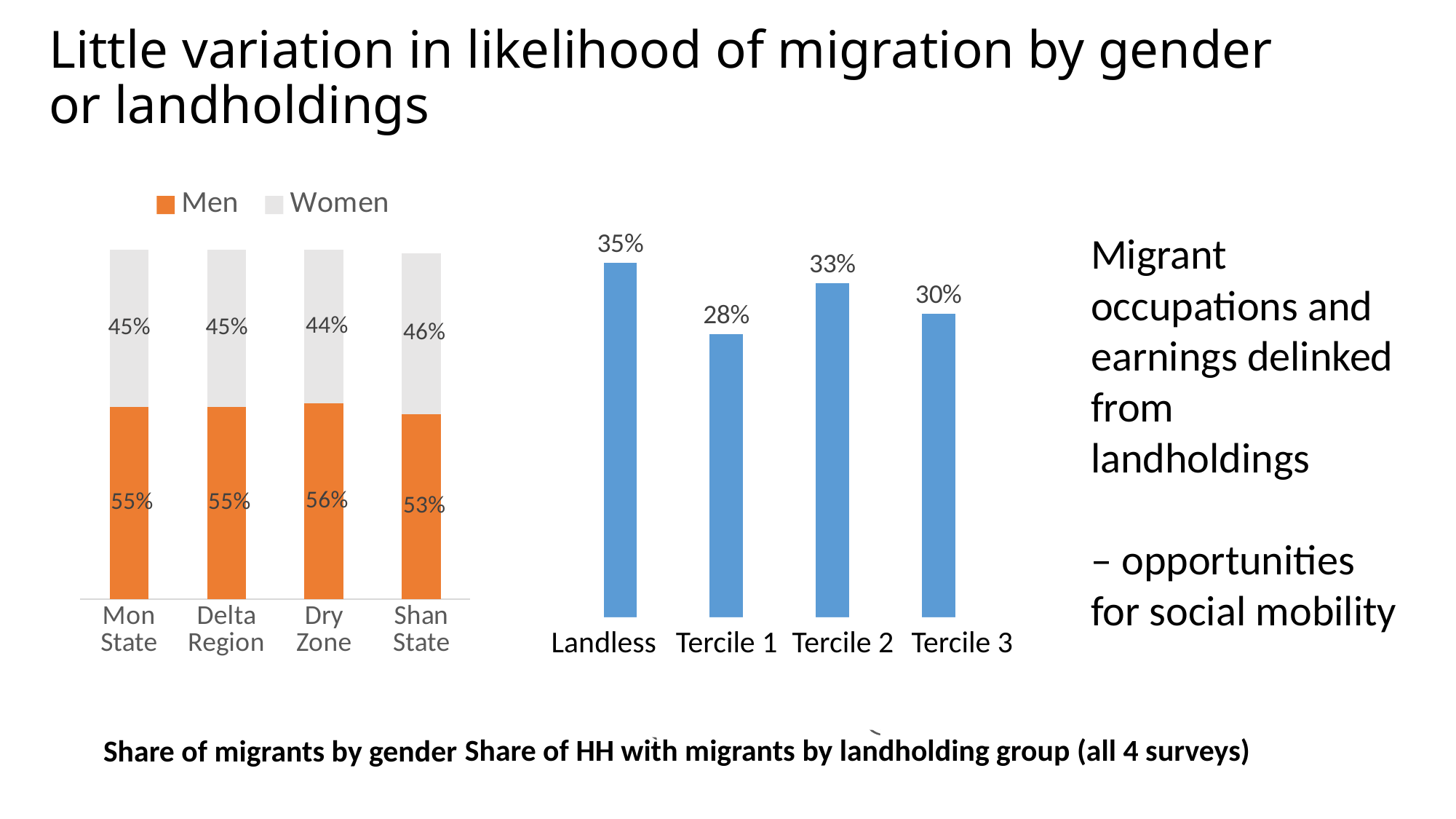
In the left chart (Share of migrants by gender), which region has the highest value for Men? Dry Zone In the right chart (Share of HH with migrants by landholding group), which group has the lowest value? Tercile 1 In the left chart (Share of migrants by gender), how many series does the legend list? 2 In the left chart (Share of migrants by gender), what is the total of the stacked bar for Mon State? 100% In the left chart (Share of migrants by gender), what is the value for Men in Dry Zone? 56% In the left chart (Share of migrants by gender), which region has the lowest value for Men? Shan State In the right chart (Share of HH with migrants by landholding group), which group has the highest value? Landless In the right chart (Share of HH with migrants by landholding group), what is the difference between Landless and Tercile 1? 7% In the left chart (Share of migrants by gender), what is the difference between Men and Women in Shan State? 7% In the right chart (Share of HH with migrants by landholding group), what is the value for Tercile 2? 33% In the right chart (Share of HH with migrants by landholding group), how many landholding groups are shown? 4 In the left chart (Share of migrants by gender), what is the value for Women in Shan State? 46%